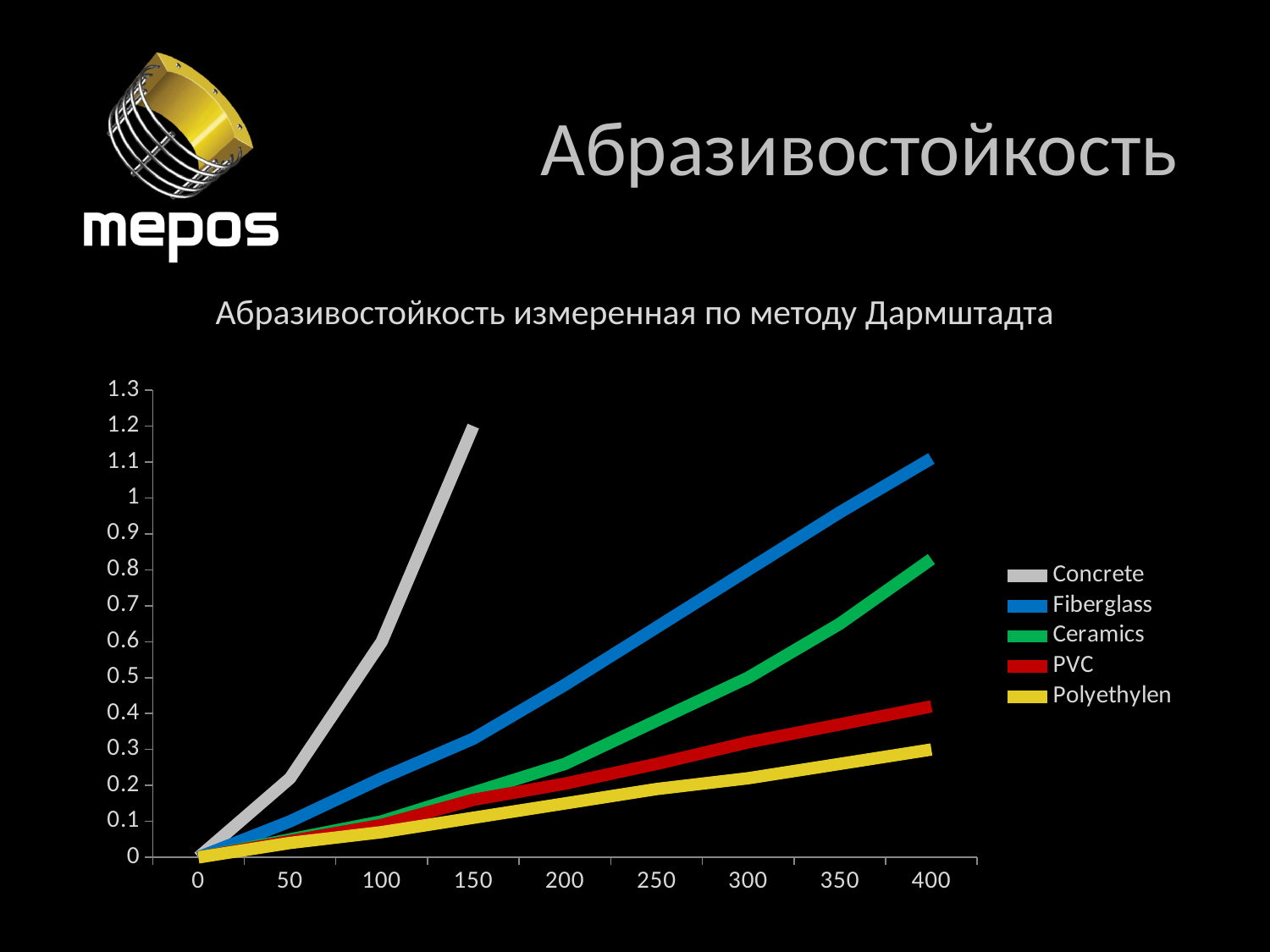
Which series has the lowest value at x = 400? Polyethylen Which colour represents Concrete in the legend? grey What kind of chart is shown on the slide? line chart Is the value for Ceramics at x = 400 greater or less than 0.7? greater Is the value for Fiberglass at x = 400 greater or less than 1? greater At x = 400, which is larger: Ceramics or PVC? Ceramics Is the value for PVC at x = 400 greater or less than 0.5? less What is the title of the chart? Абразивостойкость измеренная по методу Дармштадта Do the values of the Fiberglass series rise or fall as x increases? rise How many series does the legend list? 5 Which series has the highest value at x = 400? Fiberglass